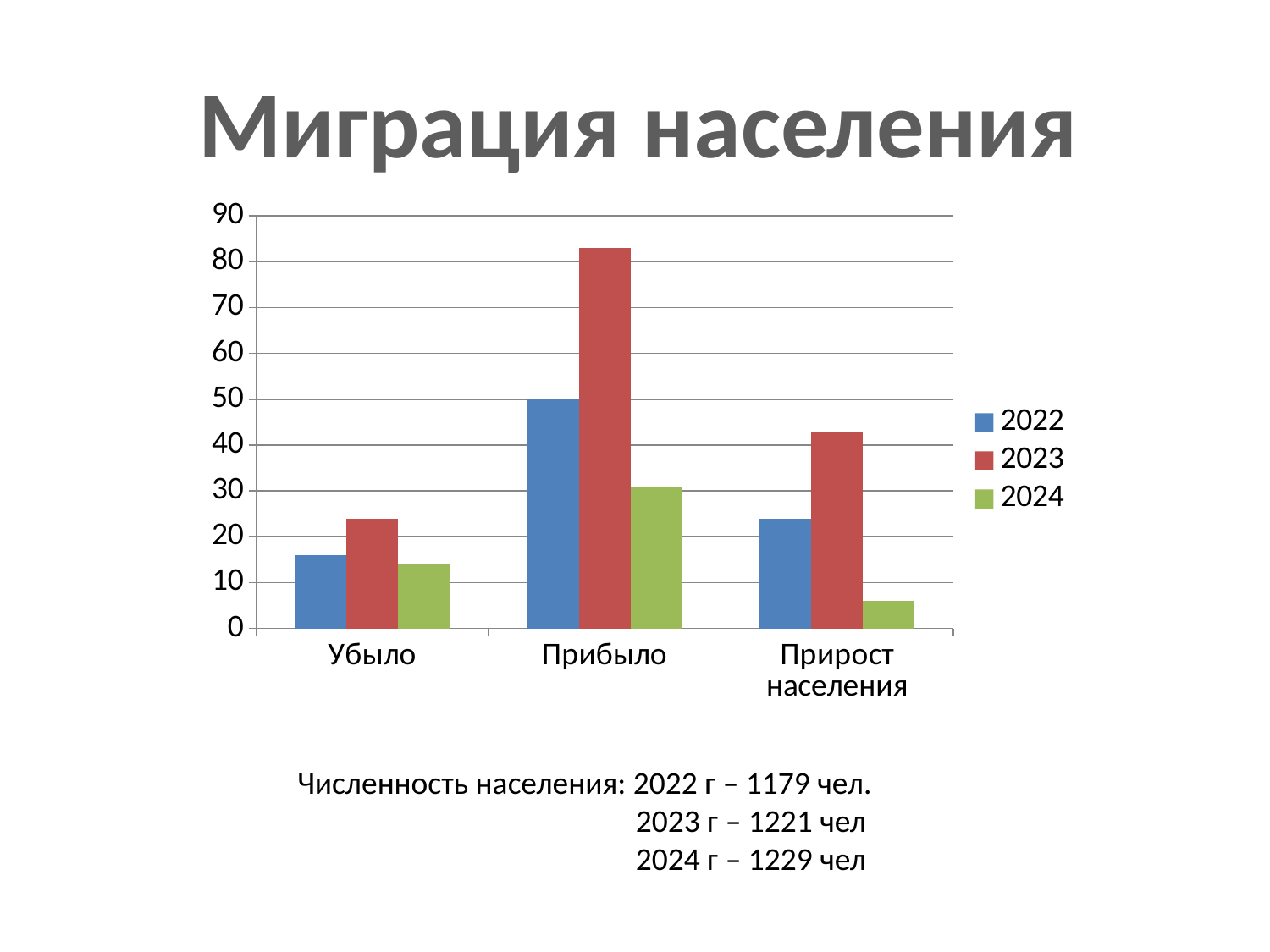
What is the title of the slide's chart? Миграция населения What kind of chart is shown on the slide? bar chart How many series does the legend list? 3 Which year has the highest value in the Прибыло category? 2023 Is the value for 2023 in the Прибыло category greater or less than 80? greater Which category has the highest value for the 2024 series? Прибыло How many categories are shown on the x axis? 3 Is the value for 2023 in the Убыло category greater or less than 20? greater What is the value for 2022 in the Прибыло category? 50 Which is larger: the 2022 value for Убыло or the 2022 value for Прирост населения? Прирост населения Which year has the lowest value in the Прирост населения category? 2024 Is the value for 2024 in the Прирост населения category greater or less than 10? less